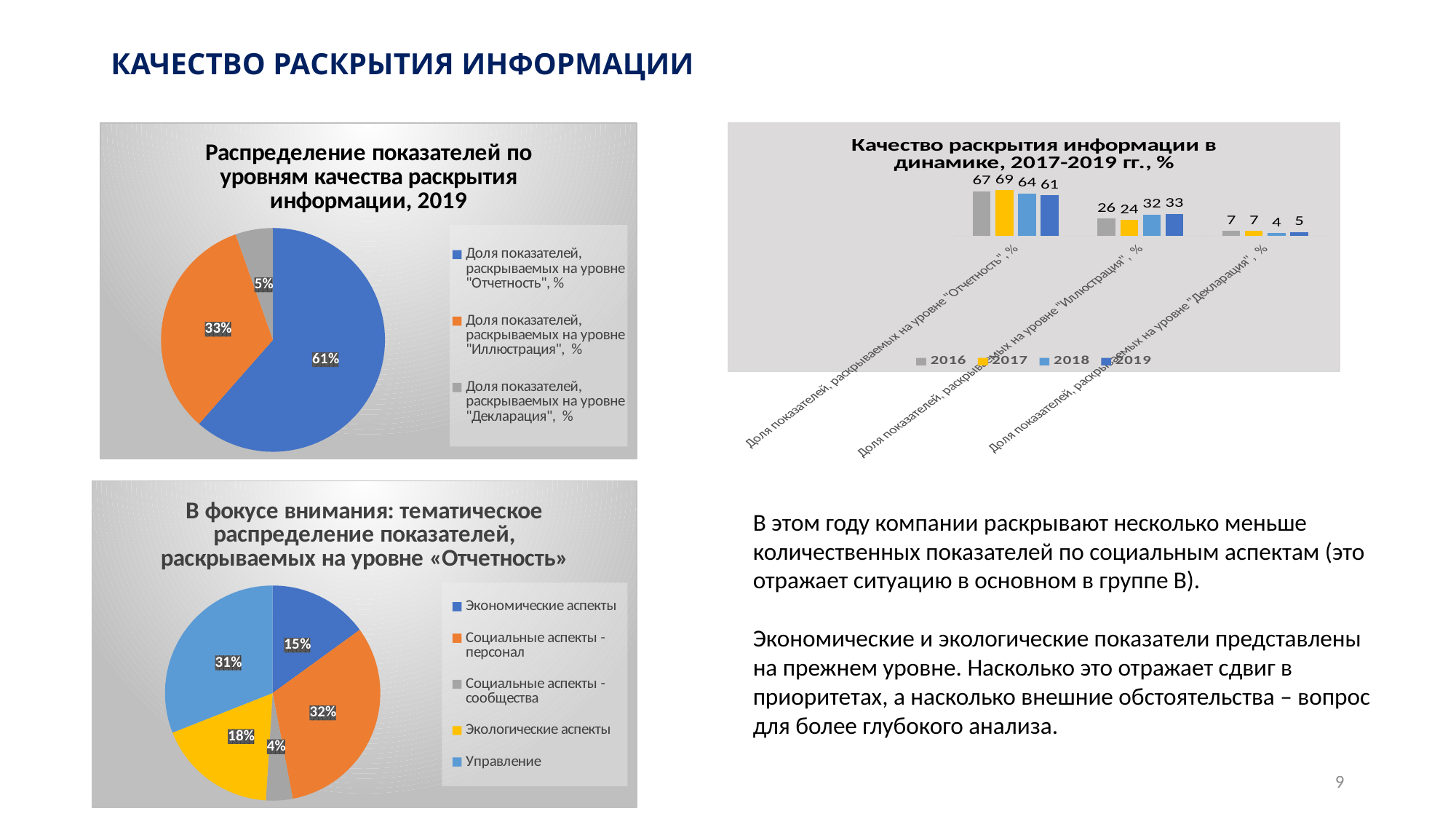
In the chart 'В фокусе внимания: тематическое распределение показателей, раскрываемых на уровне «Отчетность»', what is the share of 'Экологические аспекты'? 18% In the chart 'Распределение показателей по уровням качества раскрытия информации, 2019', what share of indicators is disclosed at the 'Отчетность' level? 61% How many categories are shown in the chart 'В фокусе внимания: тематическое распределение показателей, раскрываемых на уровне «Отчетность»'? 5 In the chart 'В фокусе внимания: тематическое распределение показателей, раскрываемых на уровне «Отчетность»', which category has the largest share? Социальные аспекты - персонал In the chart 'Качество раскрытия информации в динамике, 2017-2019 гг., %', what is the difference between the 'Декларация' values for 2016 and 2018? 3 What type of chart is 'Распределение показателей по уровням качества раскрытия информации, 2019'? Pie chart In the chart 'Распределение показателей по уровням качества раскрытия информации, 2019', what is the difference between the 'Отчетность' and 'Иллюстрация' shares? 28% In the chart 'Качество раскрытия информации в динамике, 2017-2019 гг., %', what is the value for the 'Отчетность' level in 2017? 69 In the chart 'Распределение показателей по уровням качества раскрытия информации, 2019', which level has the smallest share? Декларация In the chart 'Качество раскрытия информации в динамике, 2017-2019 гг., %', how many series does the legend list? 4 In the chart 'Качество раскрытия информации в динамике, 2017-2019 гг., %', does the value for the 'Отчетность' level rise or fall from 2017 to 2019? Fall In the chart 'Качество раскрытия информации в динамике, 2017-2019 гг., %', what is the value for the 'Иллюстрация' level in 2019? 33